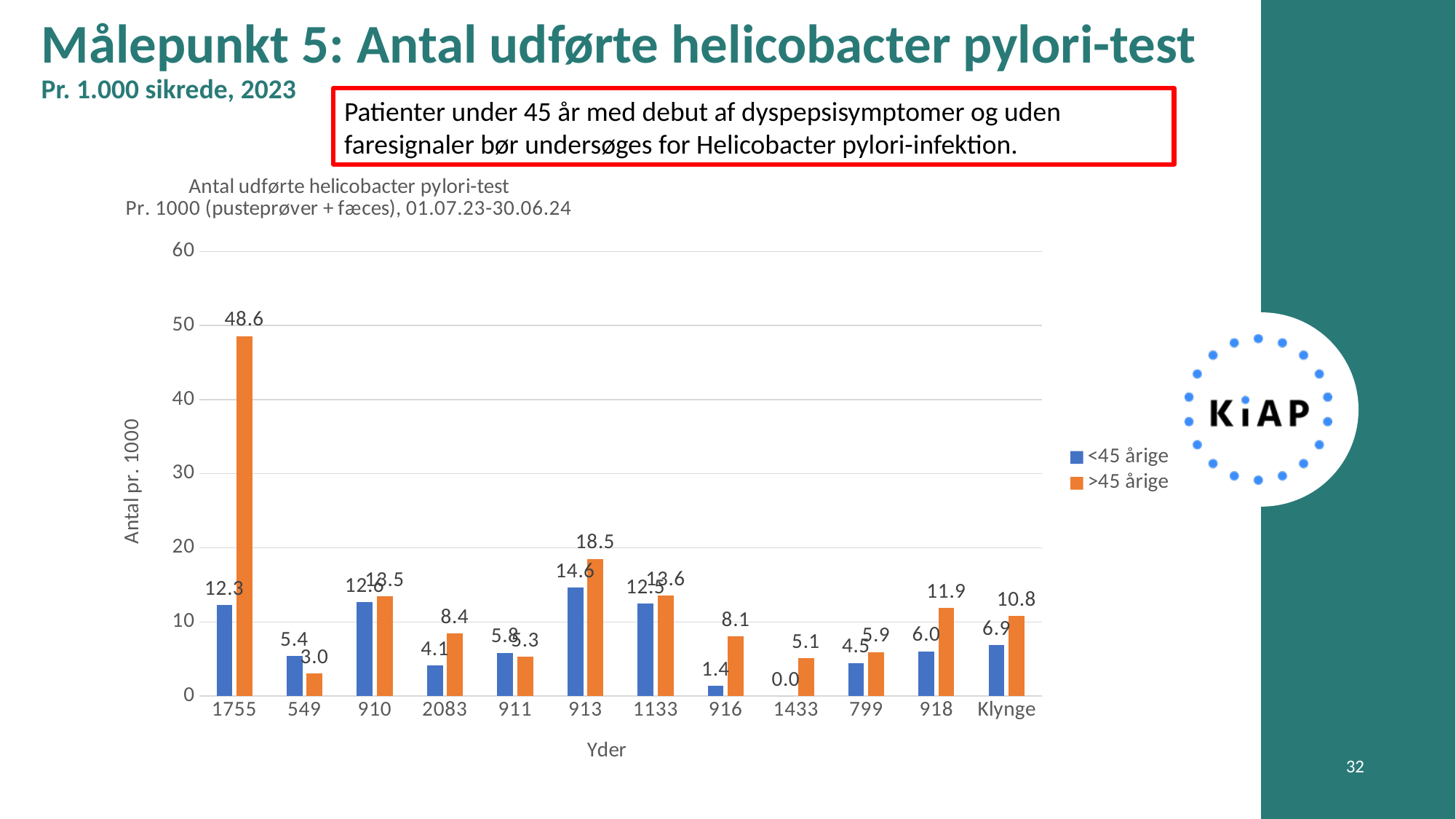
For Yder 918, what is the difference between the >45 årige value and the <45 årige value? 5.9 For Yder 549, which series has the larger value, <45 årige or >45 årige? <45 årige Which Yder has the highest value for >45 årige? 1755 What is the value for <45 årige for Yder 1433? 0.0 For Yder 1755, what is the difference between the >45 årige value and the <45 årige value? 36.3 What is the value for <45 årige for Yder 913? 14.6 How many series does the legend list? 2 What is the value for >45 årige for Klynge? 10.8 Which Yder has the lowest value for <45 årige? 1433 What is the value for >45 årige for Yder 1755? 48.6 Is the value for >45 årige for Yder 1755 greater or less than 40? greater How many categories are shown on the x axis? 12